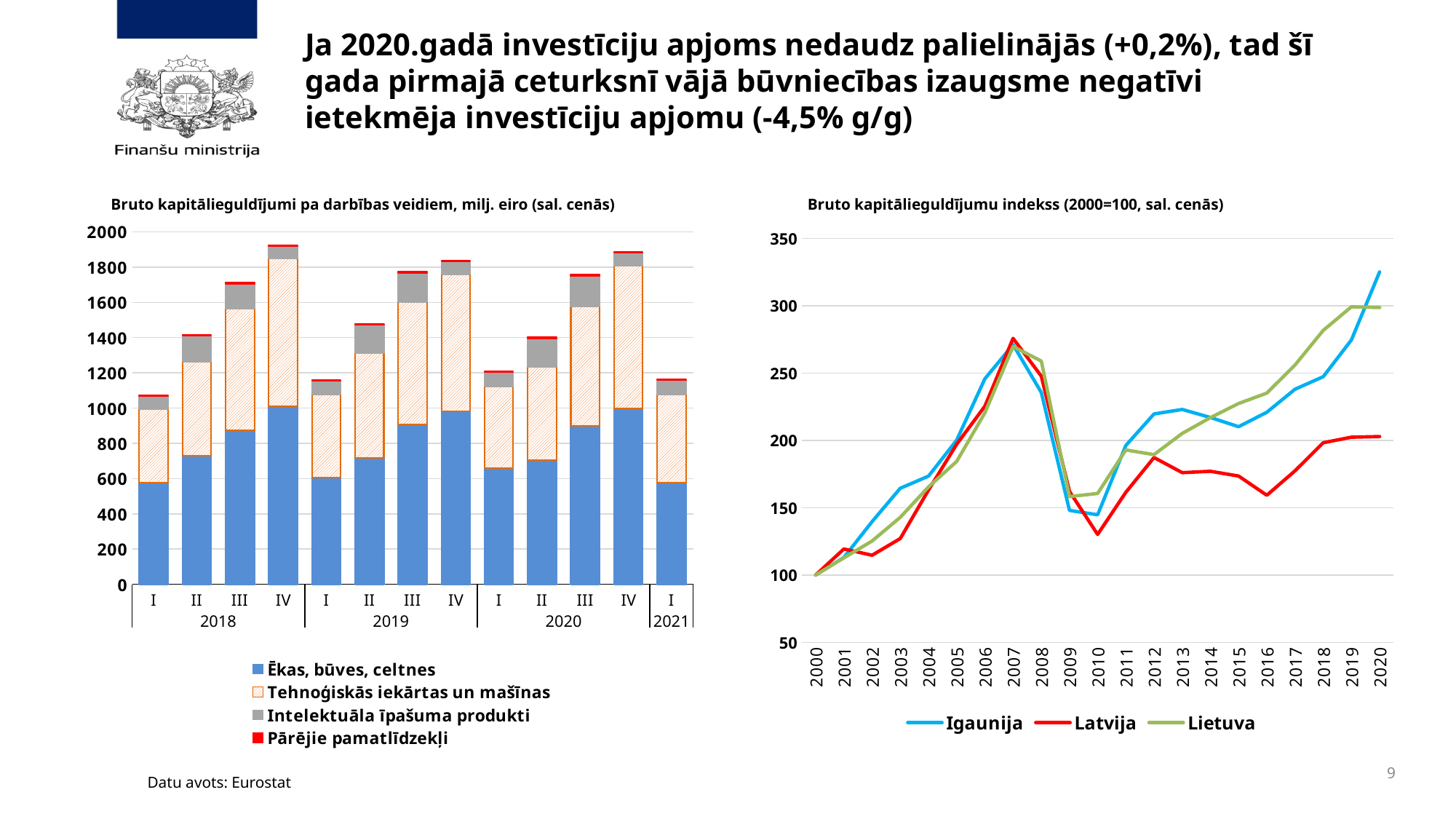
How many series does the legend of the right chart list? 3 In the left chart, is the total for 2018 IV greater or less than 1800? greater What kind of chart is the left chart, 'Bruto kapitālieguldījumi pa darbības veidiem'? Stacked bar chart What kind of chart is the right chart, 'Bruto kapitālieguldījumu indekss'? Line chart In the right chart, does the Latvija line rise or fall between 2007 and 2010? fall In the right chart, is the value for Latvija in 2010 greater or less than 150? less How many quarterly bars are shown in the left chart? 13 In the left chart, is the total for 2021 I greater or less than 1200? less How many series does the legend of the left chart list? 4 In the left chart, which quarter has the lowest total bar? 2018 I In the right chart, which country has the highest index value in 2020? Igaunija